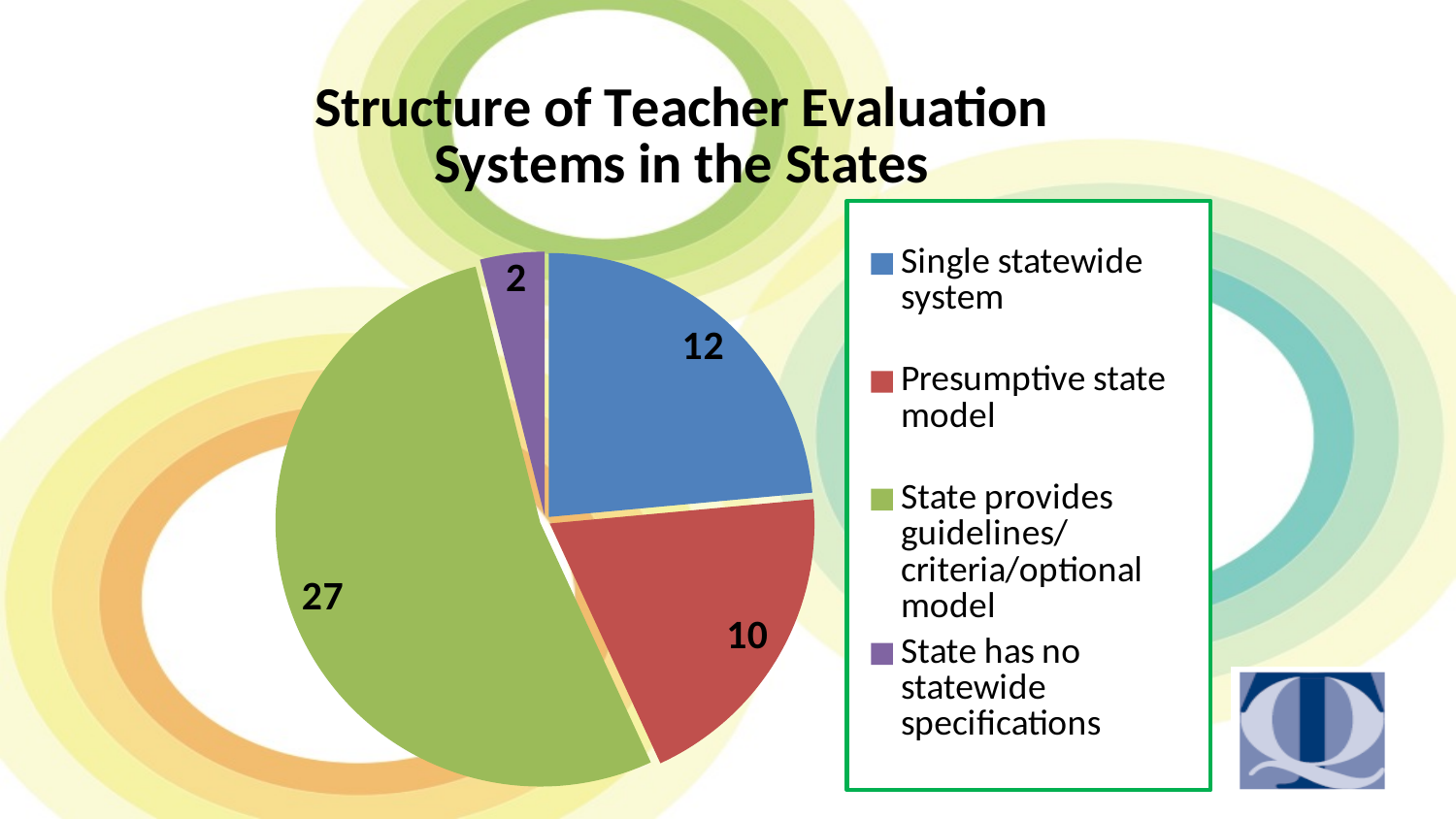
What is the title of the chart? Structure of Teacher Evaluation Systems in the States How many categories does the pie chart have? 4 What is the value for the slice where the state provides guidelines/criteria/optional model? 27 What colour is the slice for the presumptive state model? red Which is larger: the single statewide system slice or the presumptive state model slice? Single statewide system Which category has the smallest slice of the pie? State has no statewide specifications What type of chart is shown on the slide? pie chart What is the value for the presumptive state model slice? 10 How many states have a single statewide system? 12 What is the difference between the number of states that provide guidelines/criteria/optional model and the number with a single statewide system? 15 Which category has the largest slice of the pie? State provides guidelines/criteria/optional model How many states have no statewide specifications? 2